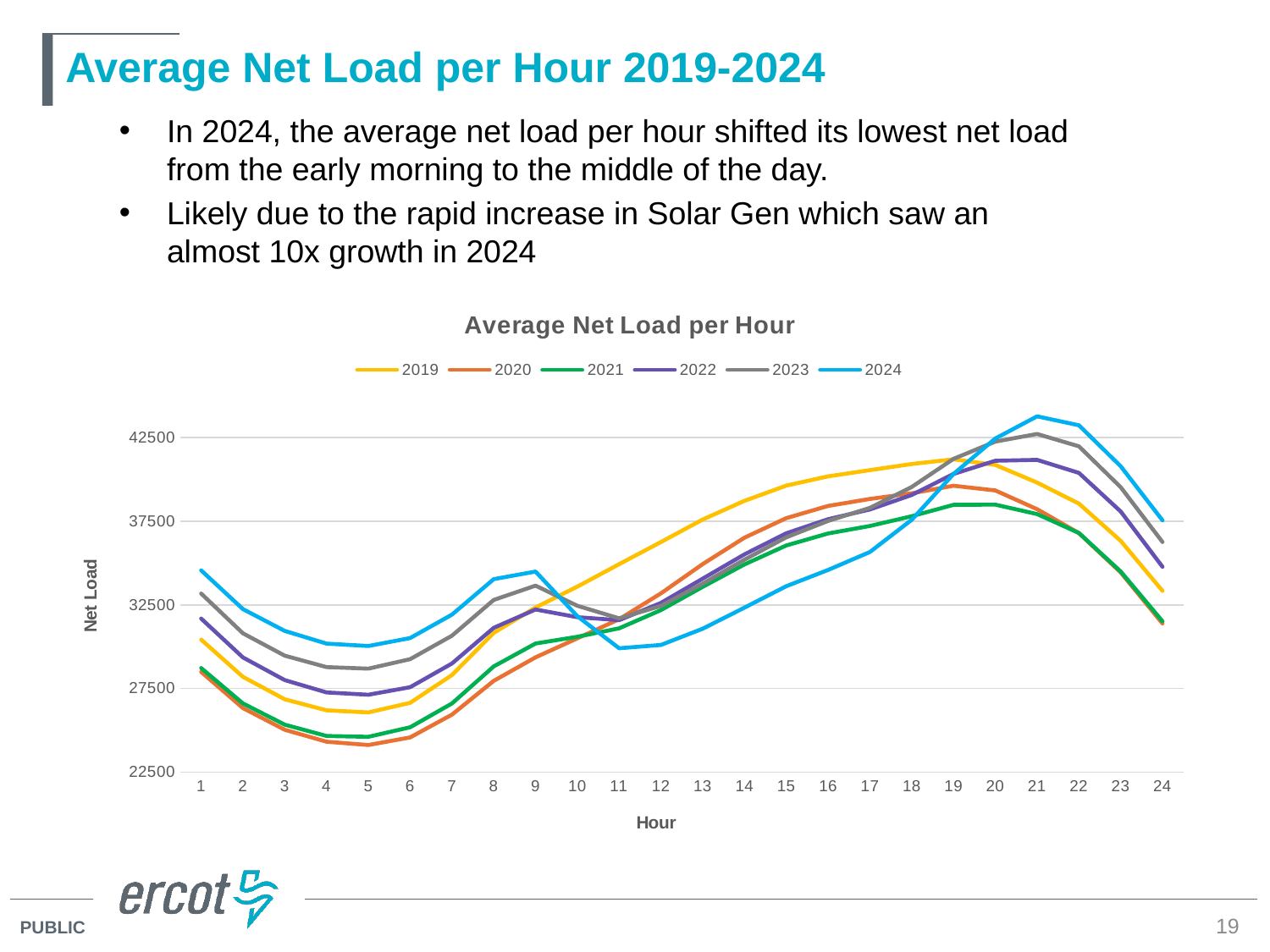
What kind of chart is shown on the slide? Line chart At which hour does the 2024 line reach its highest value? 21 Is the value for 2024 at hour 21 greater or less than 42500? greater Which year's line reaches the highest point anywhere on the chart? 2024 How many hours are plotted along the x axis of the chart? 24 Is the value for 2020 at hour 5 greater or less than 27500? less What is the title of the y axis of the chart? Net Load At hour 11, which is larger: the value for 2019 or the value for 2024? 2019 How many series does the legend of the chart list? 6 Does the 2024 line rise or fall from hour 11 to hour 21? rise Is the value for 2024 at hour 11 greater or less than 32500? less Which year has the highest net load at hour 1? 2024